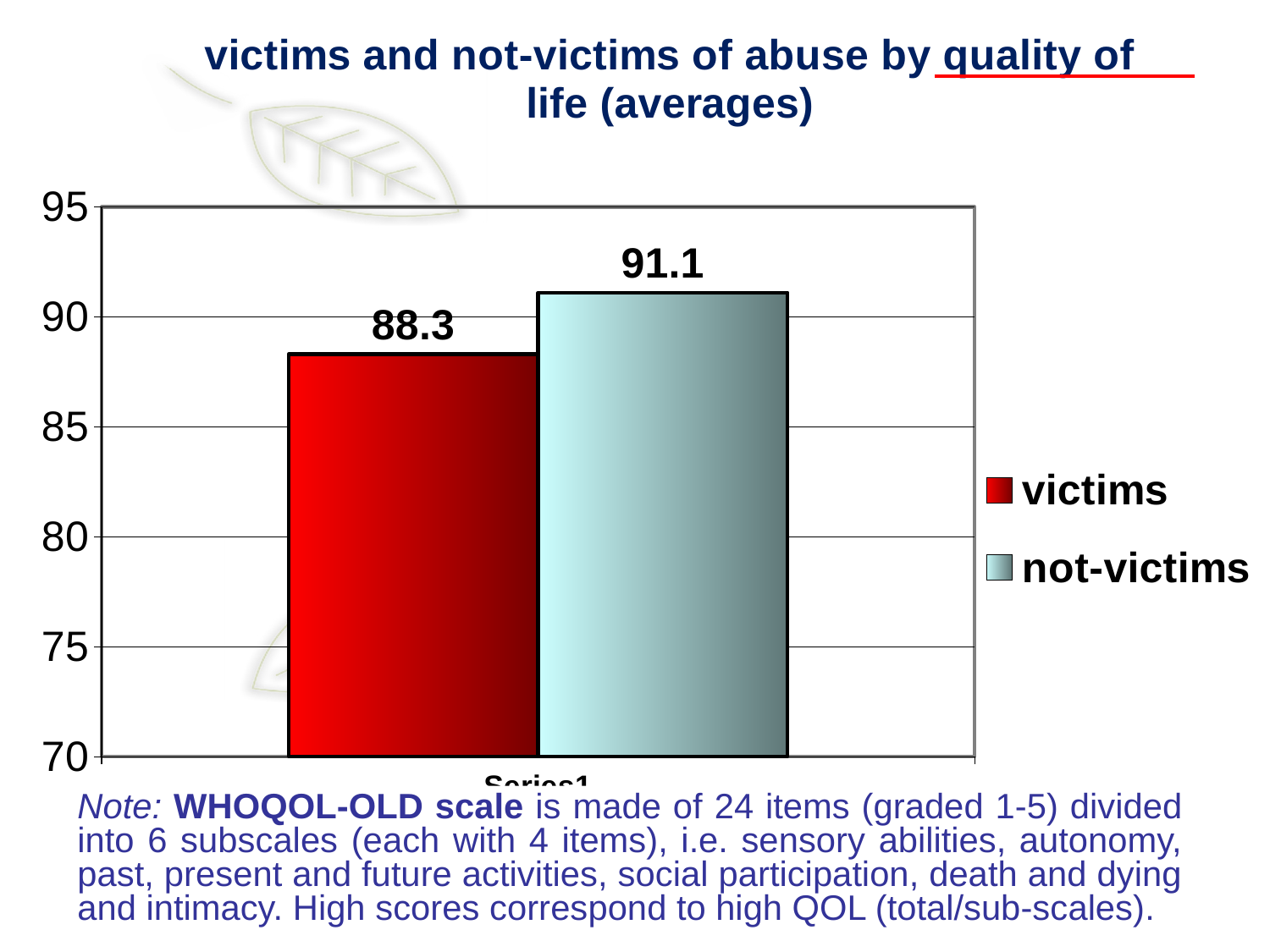
Which group has the lower average quality of life score? victims What is the difference between the not-victims and victims average quality of life scores? 2.8 Which group has the higher average quality of life score? not-victims Is the value for victims greater or less than 90? less What is the average quality of life score for not-victims? 91.1 What is the average quality of life score for victims? 88.3 How many series does the legend list? 2 What kind of chart is shown on the slide? bar chart What colour is the bar for victims? red What is the lowest value shown on the vertical axis? 70 Is the value for not-victims greater or less than 90? greater